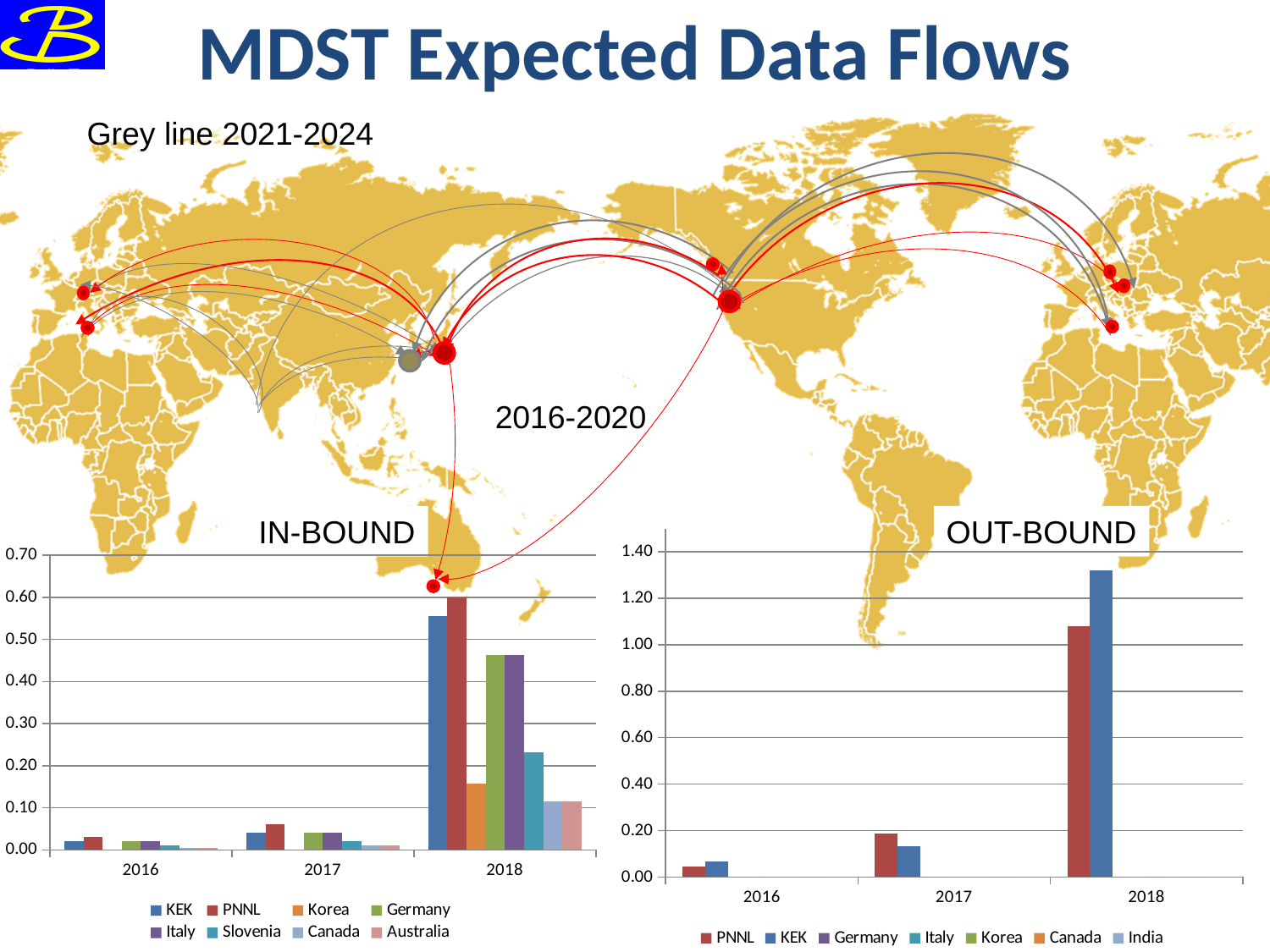
What type of chart is the IN-BOUND chart? bar chart In the IN-BOUND chart, is the KEK value for 2018 greater or less than 0.50? greater In the IN-BOUND chart, is the Slovenia value for 2018 greater or less than 0.20? greater In the IN-BOUND chart, which is larger in 2018: the KEK bar or the PNNL bar? PNNL In the OUT-BOUND chart, is the PNNL value for 2018 greater or less than 1.00? greater In the IN-BOUND chart, which series has the tallest bar in 2018? PNNL How many year categories are shown on the x axis of the OUT-BOUND chart? 3 In the OUT-BOUND chart, do the PNNL values rise or fall from 2016 to 2018? rise In the OUT-BOUND chart, which series has the tallest bar in 2018? KEK How many series does the legend of the OUT-BOUND chart list? 7 How many series does the legend of the IN-BOUND chart list? 8